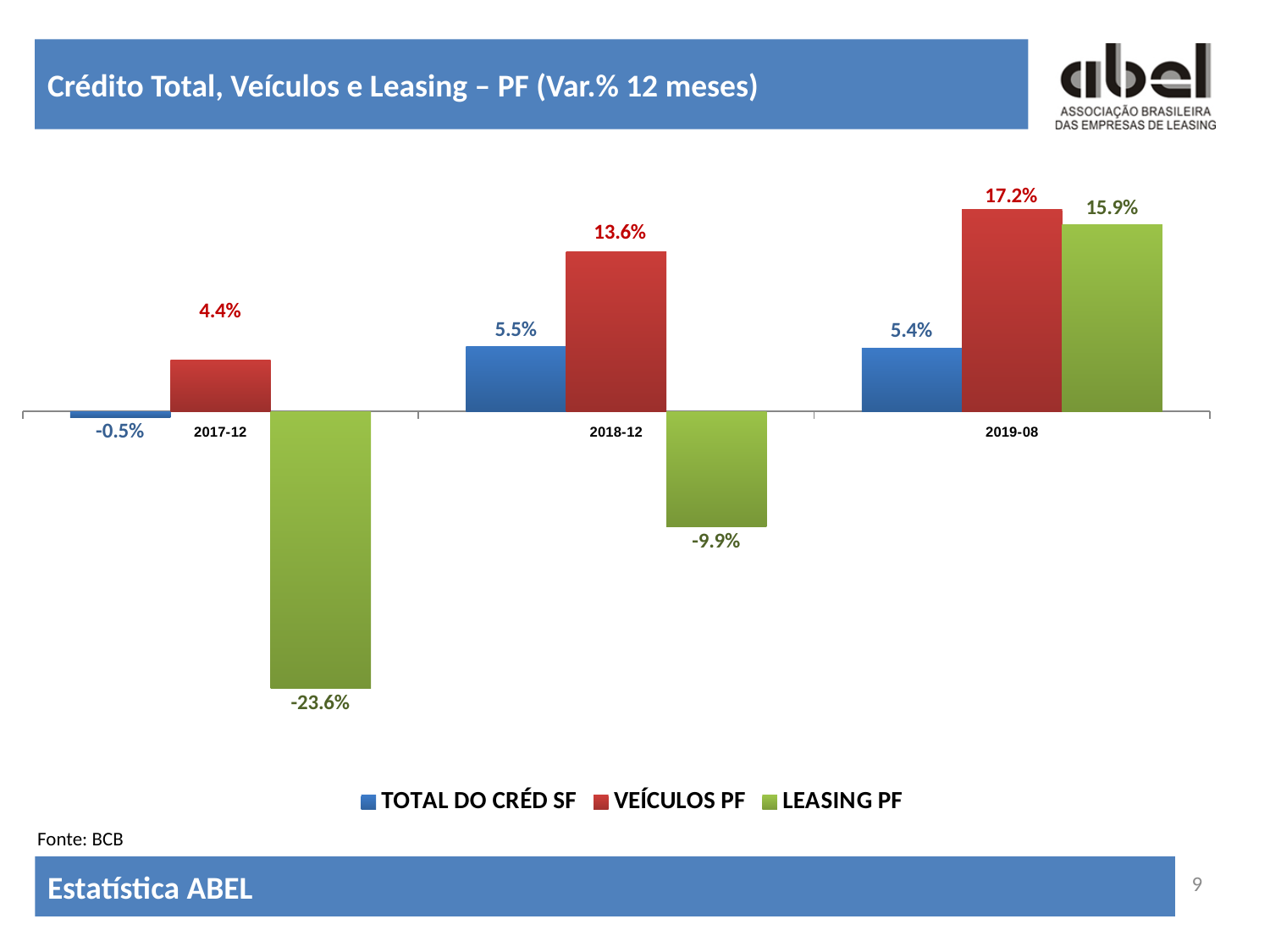
What is the difference between VEÍCULOS PF and LEASING PF in 2019-08? 1.3% What kind of chart is shown on the slide? Bar chart What is the value for TOTAL DO CRÉD SF in 2019-08? 5.4% How many series does the legend list? 3 What is the value for VEÍCULOS PF in 2018-12? 13.6% In which period is LEASING PF lowest? 2017-12 In which period is VEÍCULOS PF highest? 2019-08 Which is larger in 2018-12: TOTAL DO CRÉD SF or VEÍCULOS PF? VEÍCULOS PF What is the value for LEASING PF in 2019-08? 15.9% Does the value for LEASING PF rise or fall from 2017-12 to 2019-08? Rise What is the value for LEASING PF in 2017-12? -23.6% How many periods are shown on the x axis? 3